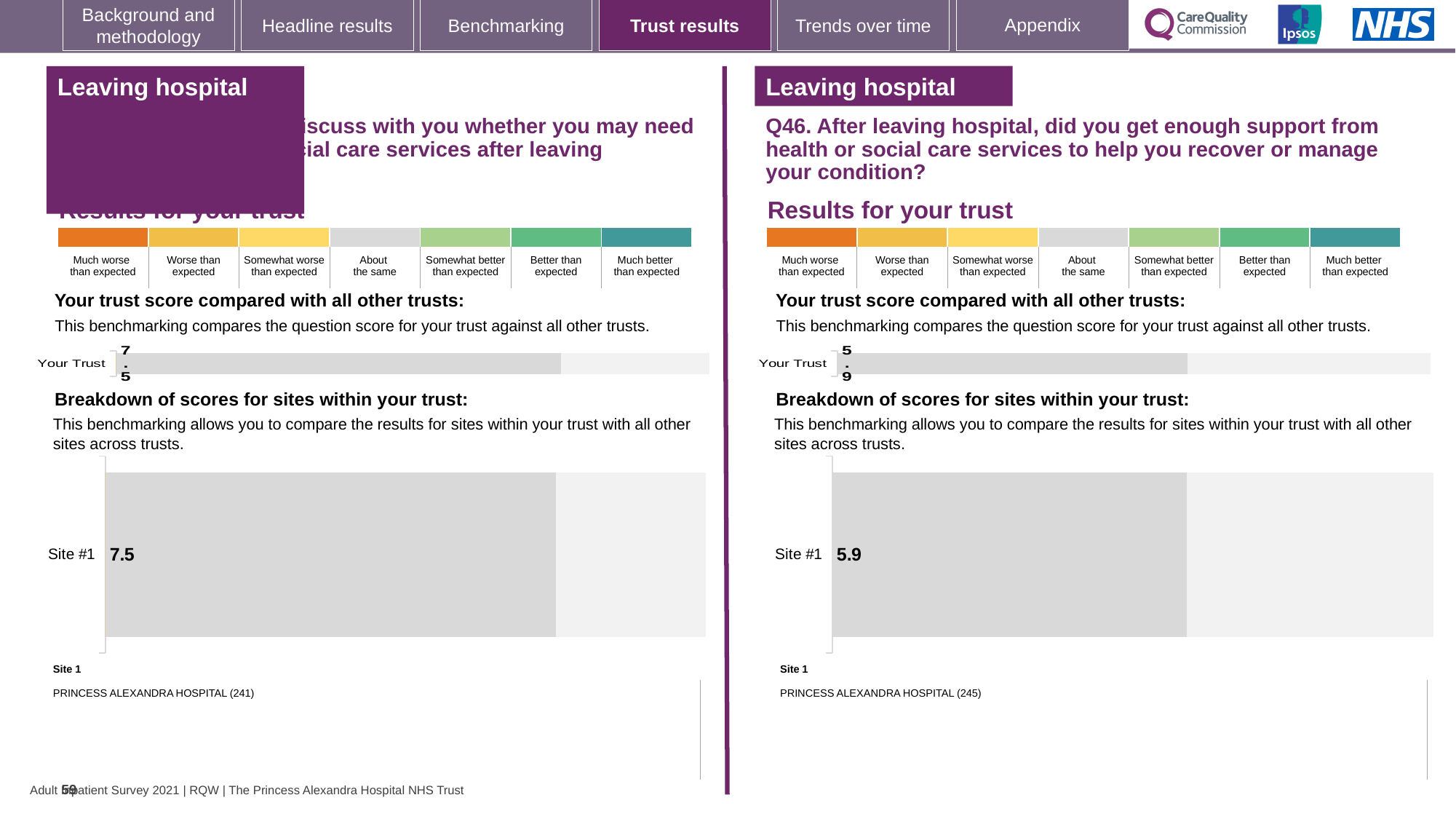
On the right-hand site breakdown chart for Q46, what is the score for Site #1? 5.9 What is the difference between the Site #1 score on the left-hand chart (7.5) and the Site #1 score on the right-hand chart for Q46 (5.9)? 1.6 On the left-hand chart, what is the score shown for Your Trust? 7.5 On the right-hand side, which hospital is listed as Site 1 for Q46? PRINCESS ALEXANDRA HOSPITAL (245) What kind of chart is used for the site breakdown for Q46 on the right-hand side? Bar chart How many sites are shown in the site breakdown chart on the left-hand side? 1 Which is larger: the Your Trust score on the left-hand chart or the Your Trust score on the right-hand chart for Q46? Left-hand chart (7.5) On the left-hand side, which hospital is listed as Site 1? PRINCESS ALEXANDRA HOSPITAL (241) On the right-hand chart for Q46, what is the score shown for Your Trust? 5.9 On the left-hand site breakdown chart, what is the score for Site #1? 7.5 How many sites are shown in the site breakdown chart for Q46 on the right-hand side? 1